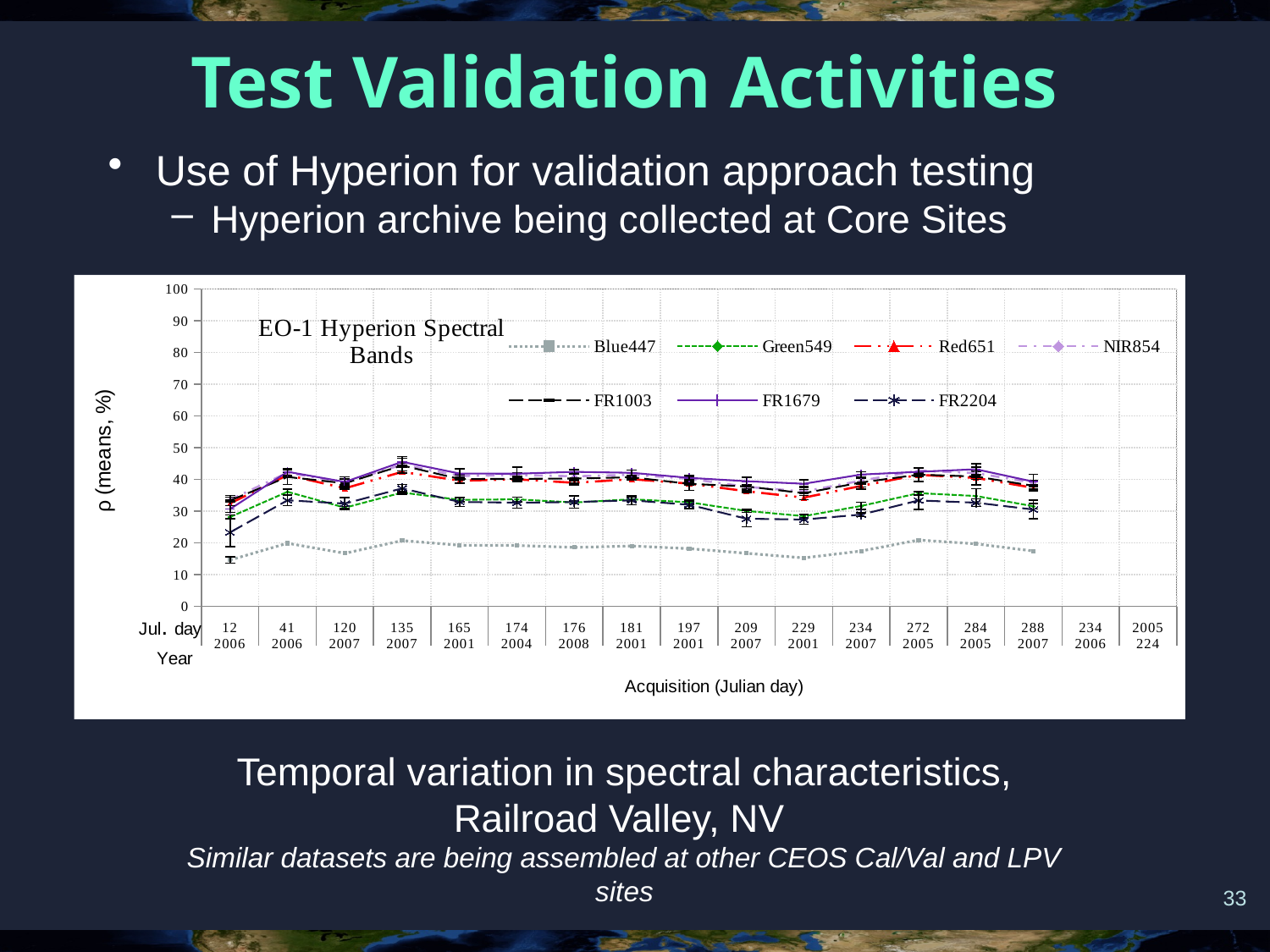
What kind of chart is shown on the slide? line chart How many series does the chart legend list? 7 Is the value for FR1679 at Julian day 135 (2007) greater or less than 40? greater Is the value for Red651 at Julian day 135 (2007) greater or less than 30? greater Is the value for Blue447 at Julian day 229 (2001) greater or less than 20? less What is the highest value shown on the y axis? 100 What is the label of the y axis? ρ (means, %) What is the title printed inside the chart? EO-1 Hyperion Spectral Bands At Julian day 135 (2007), which is larger: the value for Blue447 or the value for FR1679? FR1679 Which series has the lowest values across the chart? Blue447 Does the Blue447 series rise or fall from Julian day 12 (2006) to Julian day 41 (2006)? rise